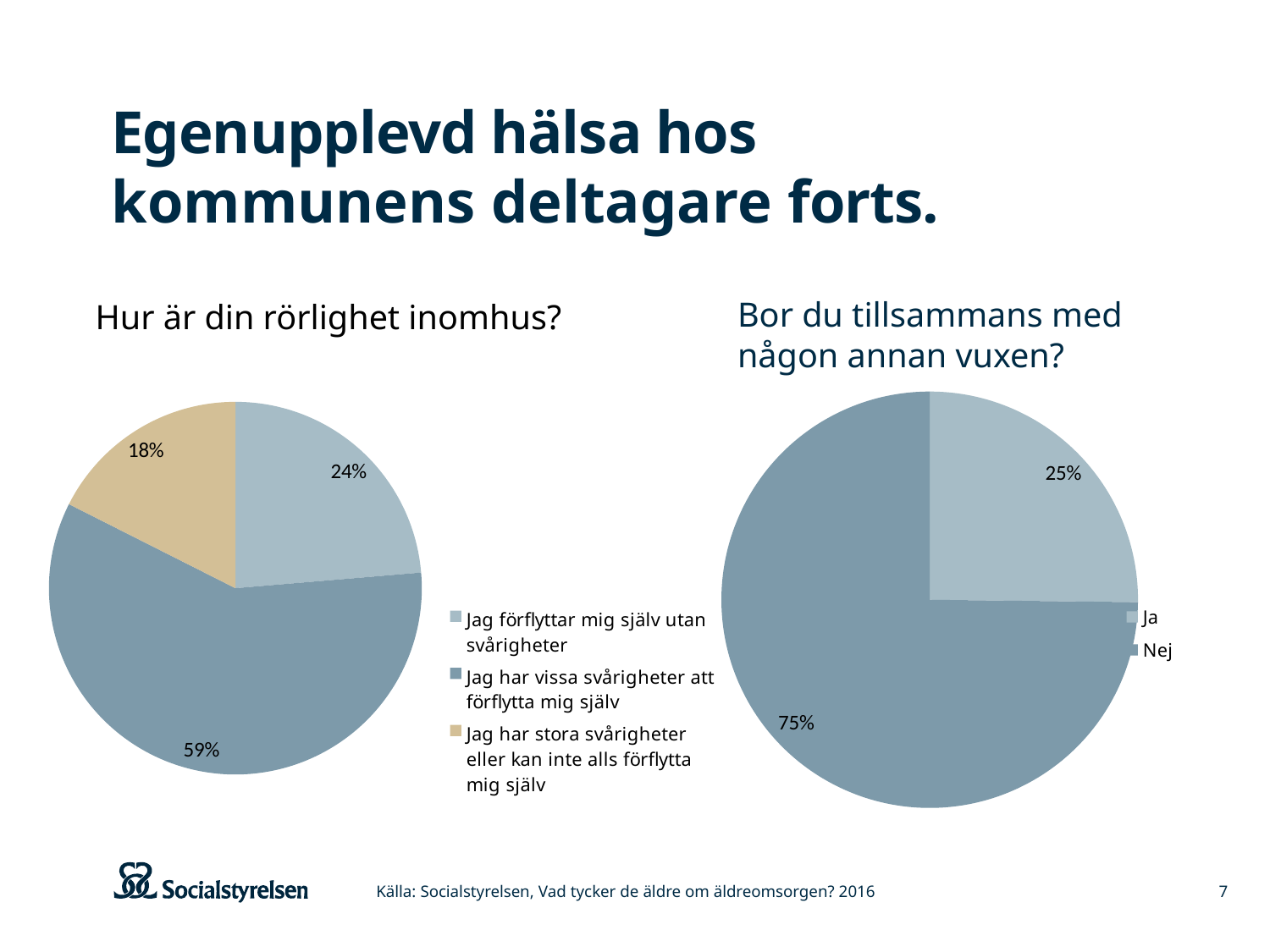
In the 'Hur är din rörlighet inomhus?' chart, what is the difference in percentage points between the 59% slice and the 24% slice? 35 percentage points In the 'Hur är din rörlighet inomhus?' chart, what share is labelled for 'Jag förflyttar mig själv utan svårigheter'? 24% How many charts are shown on the slide? 2 In the 'Bor du tillsammans med någon annan vuxen?' chart, what share answered 'Ja'? 25% In the 'Hur är din rörlighet inomhus?' chart, which category has the smallest slice? Jag har stora svårigheter eller kan inte alls förflytta mig själv In the 'Hur är din rörlighet inomhus?' chart, what share is labelled for 'Jag har vissa svårigheter att förflytta mig själv'? 59% In the 'Bor du tillsammans med någon annan vuxen?' chart, what share answered 'Nej'? 75% In the 'Hur är din rörlighet inomhus?' chart, how many categories does the legend list? 3 What kind of chart is used for 'Bor du tillsammans med någon annan vuxen?'? Pie chart In the 'Hur är din rörlighet inomhus?' chart, which category has the largest slice? Jag har vissa svårigheter att förflytta mig själv In the 'Bor du tillsammans med någon annan vuxen?' chart, which answer is larger, 'Ja' or 'Nej'? Nej In the 'Hur är din rörlighet inomhus?' chart, what share is labelled for 'Jag har stora svårigheter eller kan inte alls förflytta mig själv'? 18%